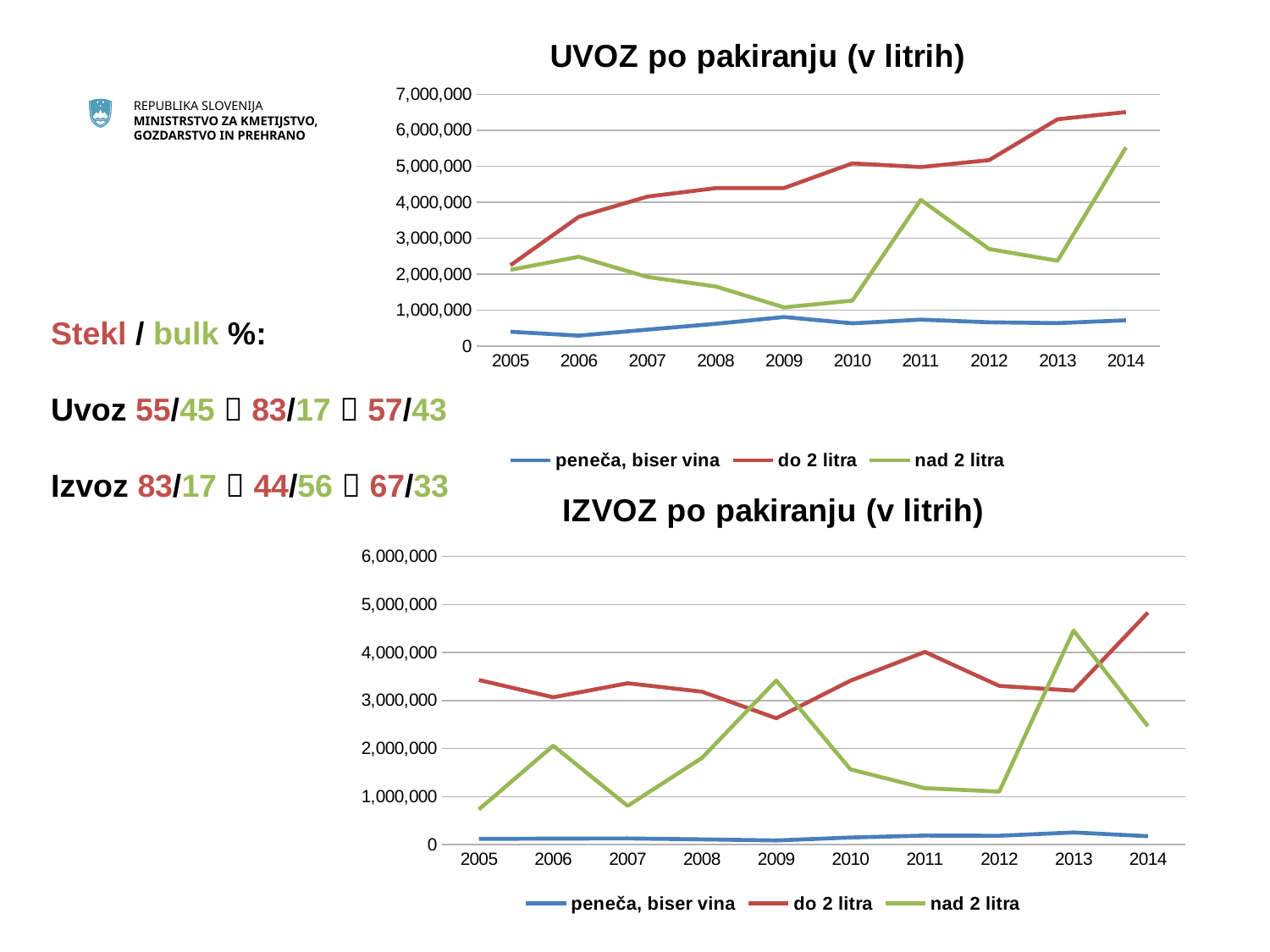
In the 'IZVOZ po pakiranju (v litrih)' chart, is the value for 'do 2 litra' in 2014 greater or less than 4,000,000? greater In the 'UVOZ po pakiranju (v litrih)' chart, which series has the lowest value in 2011? peneča, biser vina What kind of chart is the 'UVOZ po pakiranju (v litrih)' chart? line chart In the 'IZVOZ po pakiranju (v litrih)' chart, is the value for 'nad 2 litra' in 2005 greater or less than 1,000,000? less In the 'UVOZ po pakiranju (v litrih)' chart, is the value for 'do 2 litra' in 2014 greater or less than 6,000,000? greater What is the title of the lower chart on the slide? IZVOZ po pakiranju (v litrih) How many years are shown on the x axis of the 'UVOZ po pakiranju (v litrih)' chart? 10 How many series does the legend of the 'IZVOZ po pakiranju (v litrih)' chart list? 3 In the 'IZVOZ po pakiranju (v litrih)' chart, which is larger in 2013: 'do 2 litra' or 'nad 2 litra'? nad 2 litra In the 'UVOZ po pakiranju (v litrih)' chart, which series has the highest value in 2014? do 2 litra In the 'UVOZ po pakiranju (v litrih)' chart, does the 'do 2 litra' series rise or fall from 2005 to 2014? rise